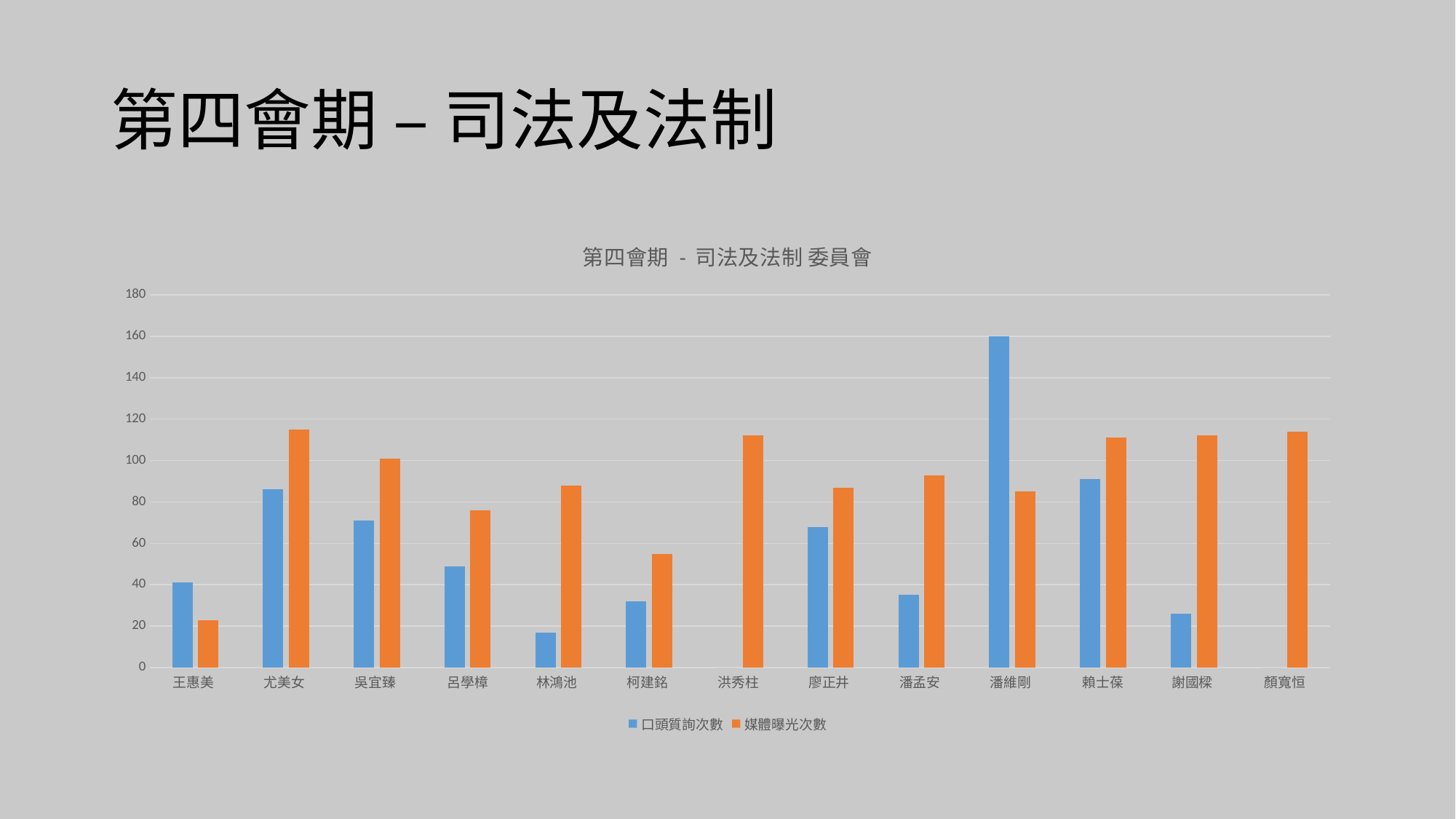
Is the 口頭質詢次數 value for 潘維剛 greater or less than 140? greater Is the 口頭質詢次數 value for 賴士葆 greater or less than 80? greater Which legislator has the lowest 媒體曝光次數? 王惠美 Is the 媒體曝光次數 value for 王惠美 greater or less than 40? less What kind of chart is shown on the slide? bar chart Which legislator has the highest 口頭質詢次數? 潘維剛 How many series does the legend list? 2 For 潘維剛, which is larger: 口頭質詢次數 or 媒體曝光次數? 口頭質詢次數 What is the title of the chart? 第四會期 - 司法及法制 委員會 How many legislators (categories) are shown on the x axis? 13 For 尤美女, which is larger: 口頭質詢次數 or 媒體曝光次數? 媒體曝光次數